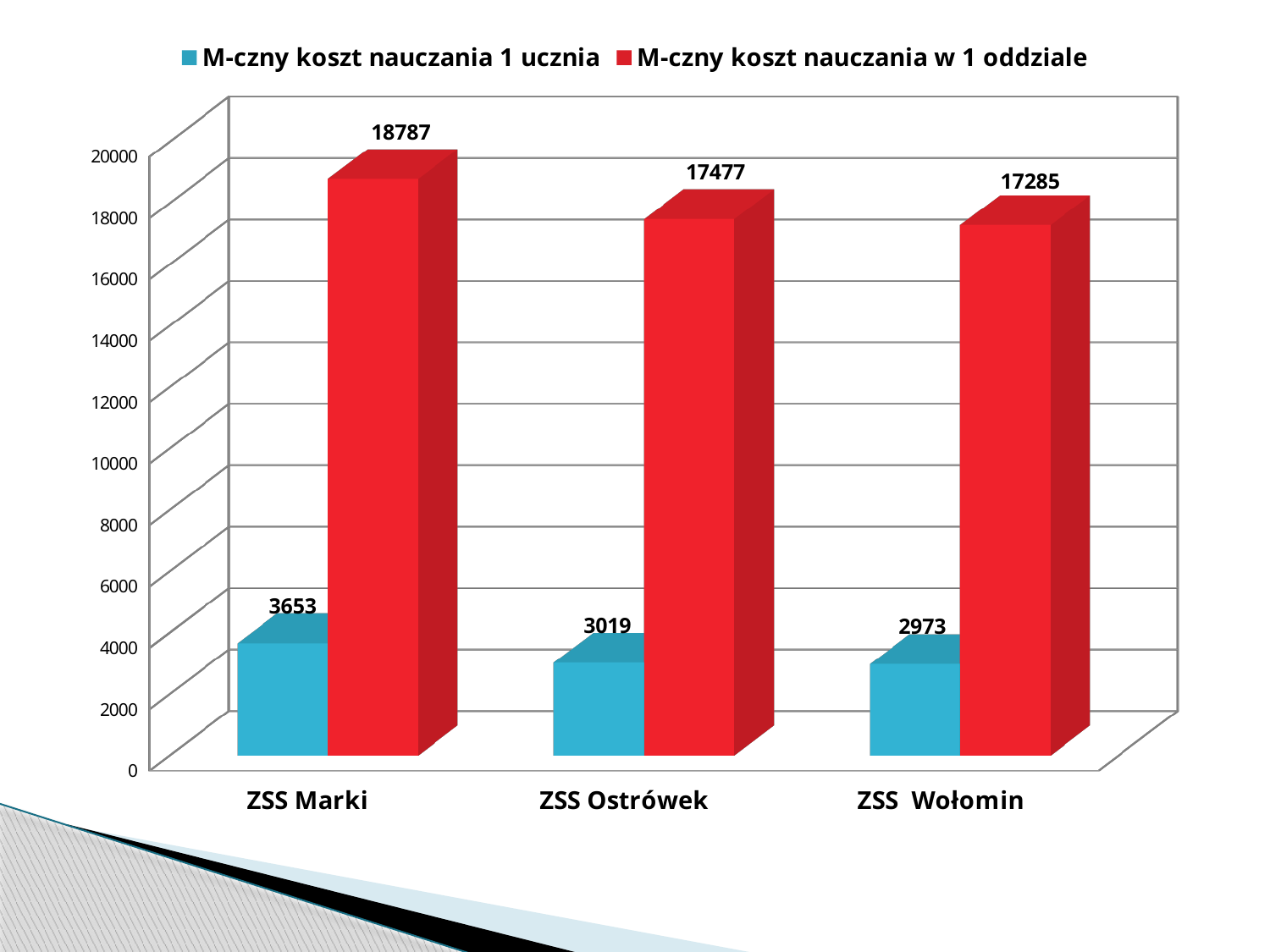
How many series does the legend list? 2 Which is larger: the "M-czny koszt nauczania 1 ucznia" for ZSS Ostrówek or for ZSS Wołomin? ZSS Ostrówek How many schools are shown on the x axis? 3 Which school has the highest "M-czny koszt nauczania w 1 oddziale"? ZSS Marki What is the value of "M-czny koszt nauczania 1 ucznia" for ZSS Wołomin? 2973 What kind of chart is shown on the slide? bar chart Which school has the lowest "M-czny koszt nauczania 1 ucznia"? ZSS Wołomin What is the value of "M-czny koszt nauczania 1 ucznia" for ZSS Marki? 3653 Is the "M-czny koszt nauczania w 1 oddziale" for ZSS Marki greater or less than 18000? greater What is the value of "M-czny koszt nauczania w 1 oddziale" for ZSS Ostrówek? 17477 What is the difference between the "M-czny koszt nauczania 1 ucznia" values for ZSS Marki and ZSS Ostrówek? 634 What is the difference between the "M-czny koszt nauczania w 1 oddziale" values for ZSS Marki and ZSS Wołomin? 1502